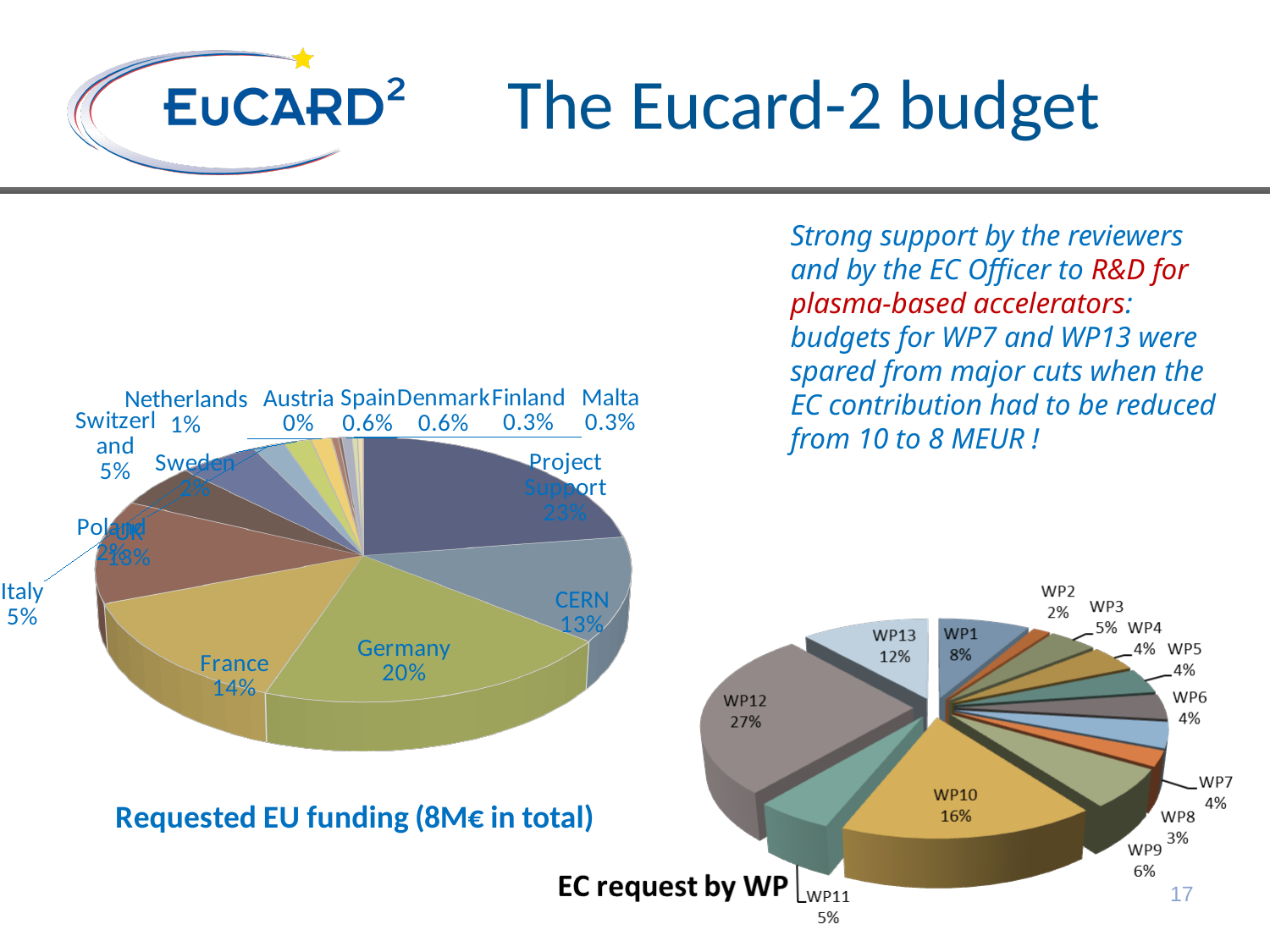
What type of chart is the 'EC request by WP' chart? Pie chart In the 'EC request by WP' chart, which work package has the largest share? WP12 In the 'Requested EU funding (8M€ in total)' chart, what is the difference between the shares of Germany and France? 6% In the 'Requested EU funding (8M€ in total)' chart, which has the larger share, CERN or France? France In the 'Requested EU funding (8M€ in total)' chart, what share does Germany have? 20% In the 'Requested EU funding (8M€ in total)' chart, what share does Project Support have? 23% In the 'EC request by WP' chart, which work package has the smallest share? WP2 How many work packages are shown in the 'EC request by WP' chart? 13 In the 'EC request by WP' chart, what share does WP12 have? 27% In the 'EC request by WP' chart, what is the difference between the shares of WP10 and WP13? 4% In the 'Requested EU funding (8M€ in total)' chart, which category has the largest share? Project Support In the 'Requested EU funding (8M€ in total)' chart, what share does Finland have? 0.3%